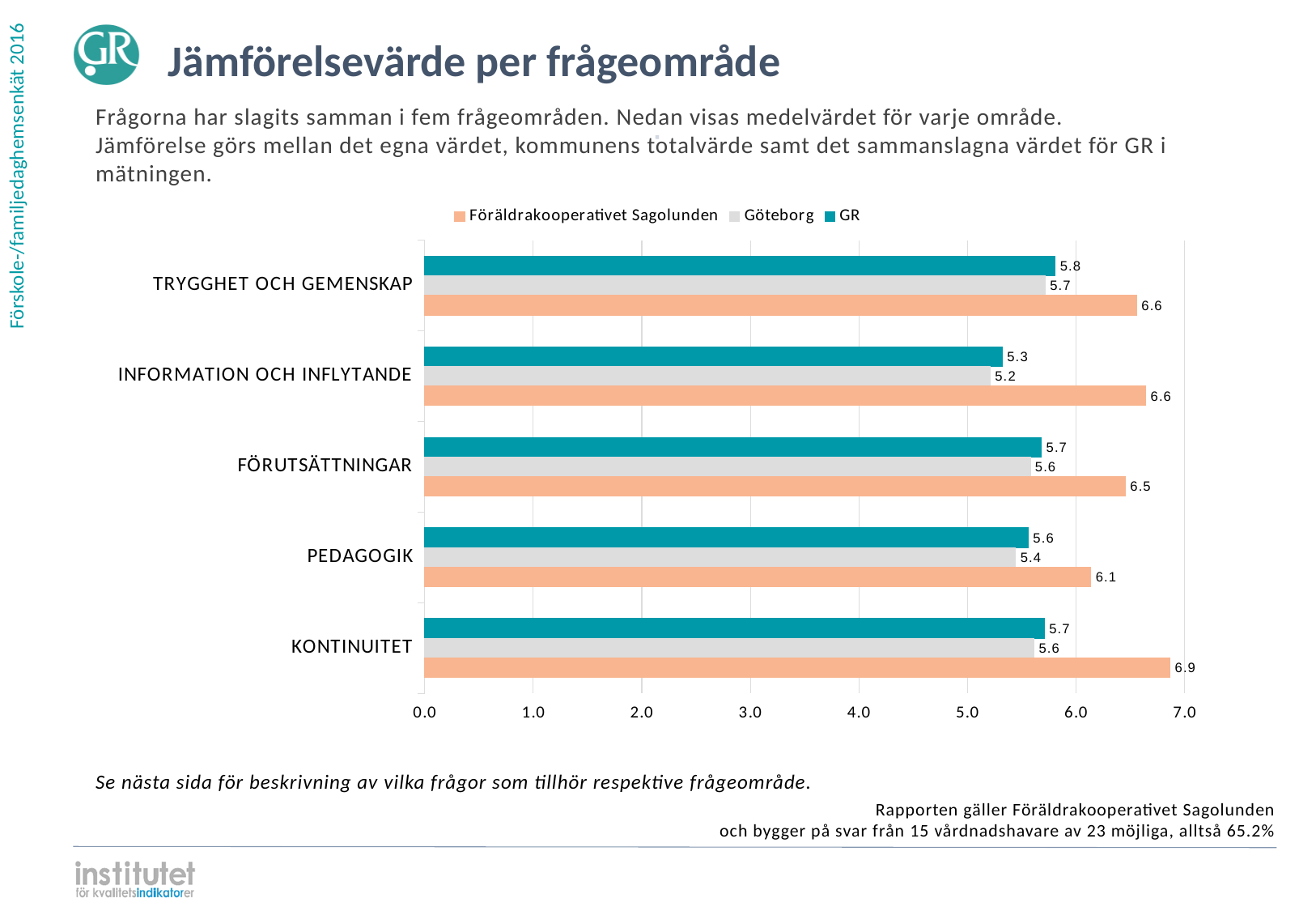
What is the difference between the Föräldrakooperativet Sagolunden value and the Göteborg value in the PEDAGOGIK category? 0.7 How many categories are shown on the chart? 5 Which category has the highest value for Föräldrakooperativet Sagolunden? KONTINUITET How many series does the legend list? 3 What is the title of the chart on the slide? Jämförelsevärde per frågeområde What is the value for GR in the TRYGGHET OCH GEMENSKAP category? 5.8 Is the value for Föräldrakooperativet Sagolunden in the PEDAGOGIK category greater or less than 6.0? greater Which is larger in the FÖRUTSÄTTNINGAR category: the GR value or the Göteborg value? GR Which category has the lowest value for Göteborg? INFORMATION OCH INFLYTANDE What is the value for Göteborg in the INFORMATION OCH INFLYTANDE category? 5.2 What kind of chart is shown on the slide? bar chart What is the value for Föräldrakooperativet Sagolunden in the KONTINUITET category? 6.9